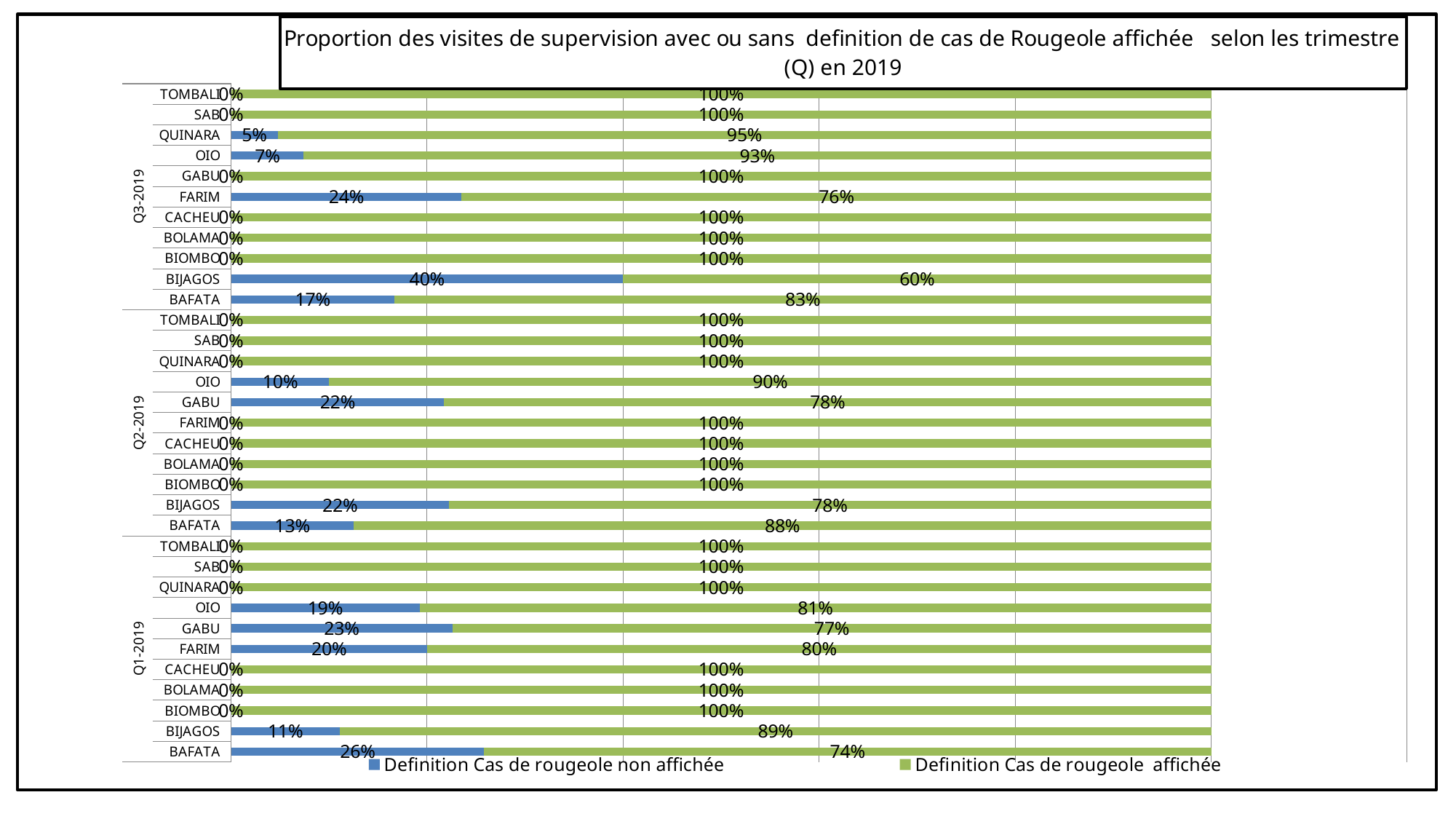
Within Q3-2019, which region has the highest value for 'Definition Cas de rougeole non affichée'? BIJAGOS How many region bars are plotted in total across the three quarters? 33 What is the value of 'Definition Cas de rougeole affichée' for OIO in Q2-2019? 90% What is the value of 'Definition Cas de rougeole non affichée' for BAFATA in Q1-2019? 26% Within Q1-2019, which region has the lowest value for 'Definition Cas de rougeole affichée'? BAFATA What is the value of 'Definition Cas de rougeole affichée' for FARIM in Q3-2019? 76% How many series does the legend list? 2 Which is larger: the 'Definition Cas de rougeole non affichée' value for GABU in Q1-2019 or for GABU in Q2-2019? GABU in Q1-2019 What is the difference between the 'Definition Cas de rougeole affichée' values for BIJAGOS in Q3-2019 and BIJAGOS in Q2-2019? 18% What is the value of 'Definition Cas de rougeole non affichée' for BIJAGOS in Q3-2019? 40% What kind of chart is shown on the slide? bar chart What is the total of the stacked bar for FARIM in Q1-2019? 100%